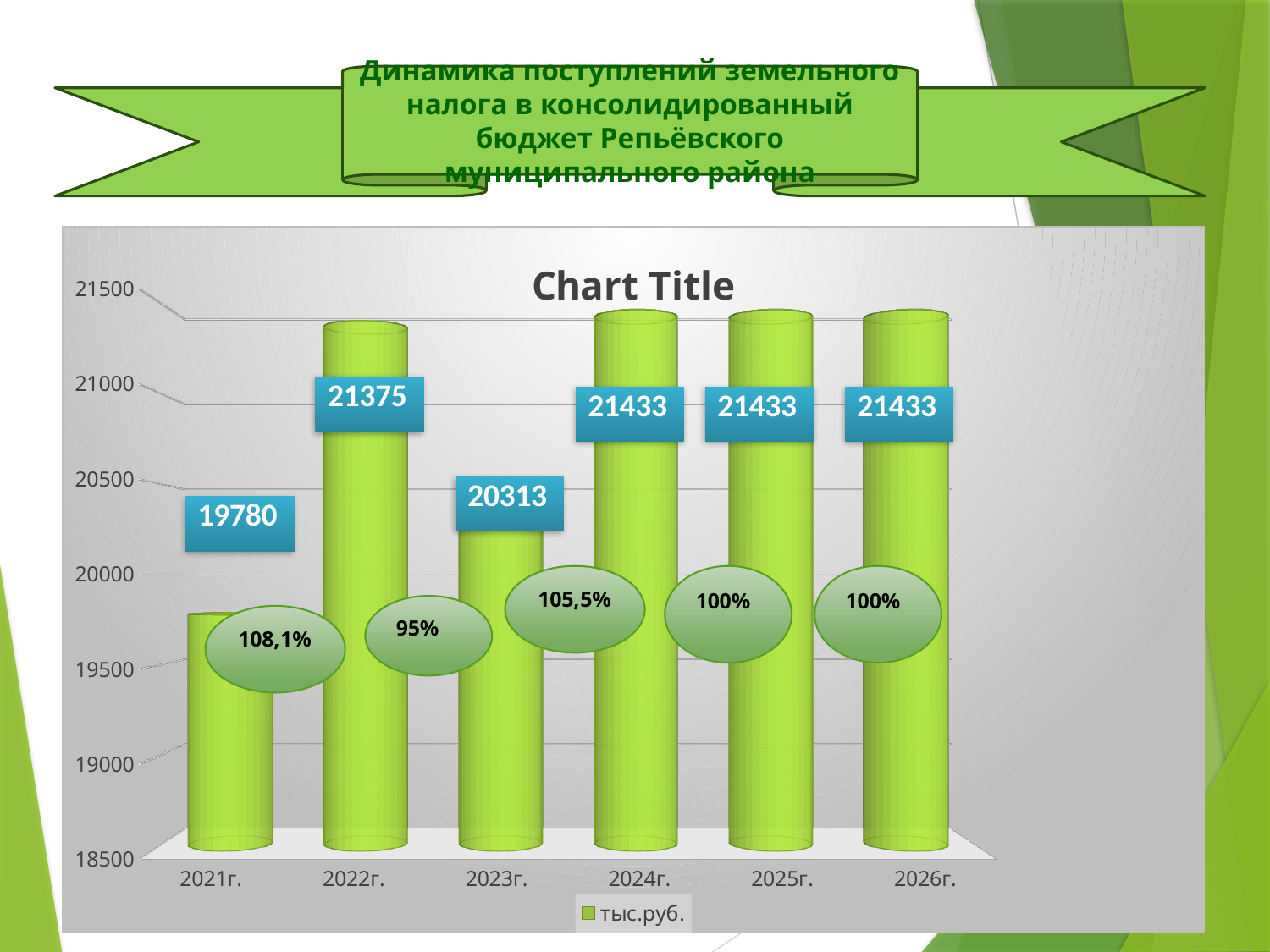
What is the value for 2023г.? 20313 What is the difference between the values for 2022г. and 2021г.? 1595 What is the value for 2021г.? 19780 What kind of chart is shown? bar chart Is the value for 2021г. greater or less than 20000? less Which year has the lowest value? 2021г. What is the value for 2022г.? 21375 What is the difference between the values for 2024г. and 2023г.? 1120 Which is larger, the value for 2022г. or the value for 2023г.? 2022г. What is the value for 2024г.? 21433 What series name does the legend show? тыс.руб. How many years are shown on the x axis? 6